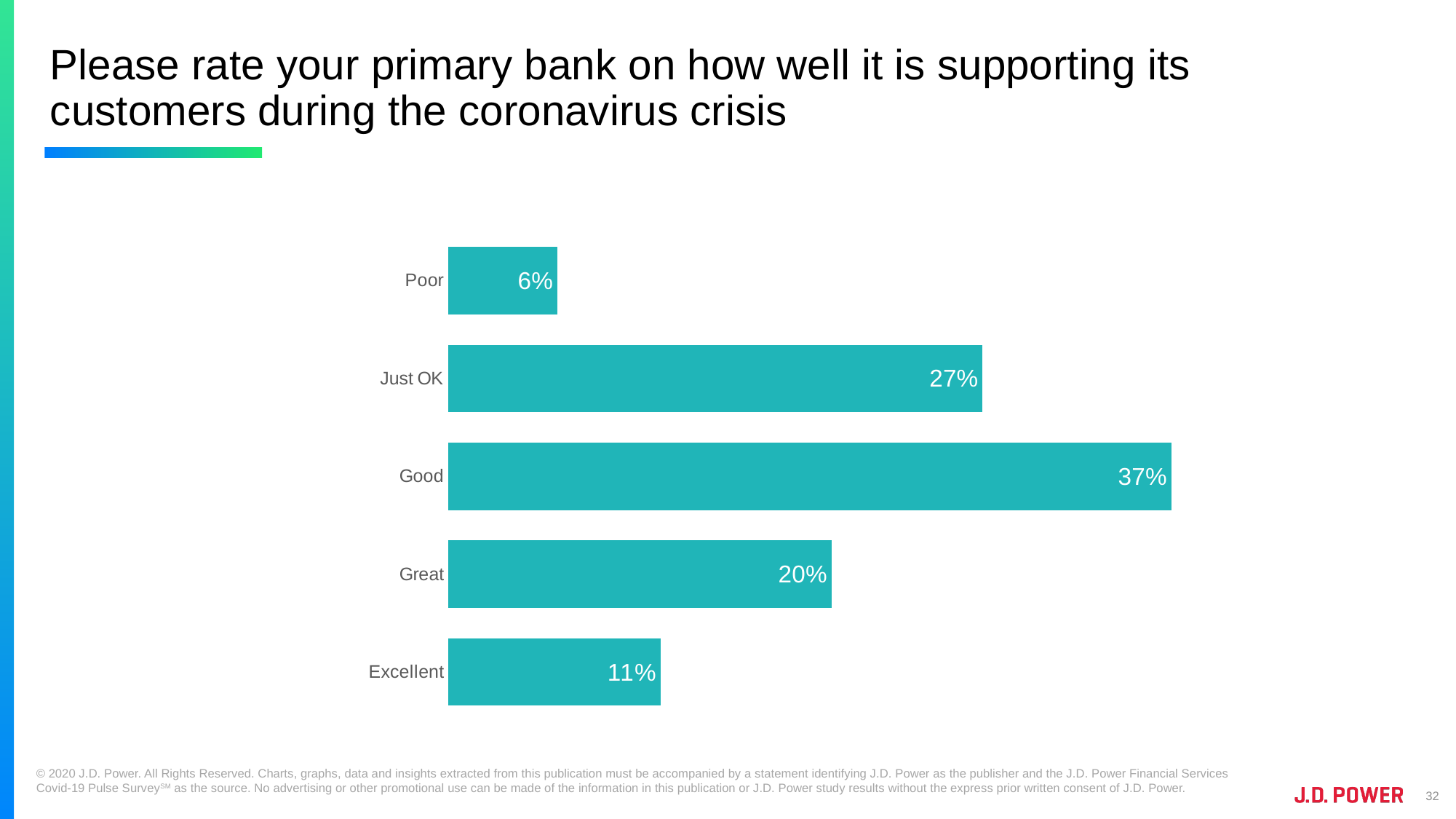
Which has a larger percentage, Just OK or Great? Just OK How many rating categories are shown in the chart? 5 What percentage of respondents rated their primary bank as Excellent? 11% What is the difference in percentage points between the Good and Just OK ratings? 10 What is the difference in percentage points between the Great and Excellent ratings? 9 What type of chart is shown on the slide? Bar chart What percentage of respondents rated their primary bank as Poor? 6% What percentage of respondents rated their primary bank as Good? 37% Which rating category has the highest percentage? Good Which rating category has the lowest percentage? Poor What percentage of respondents rated their primary bank as Just OK? 27% What is the combined percentage of respondents who rated their bank Great or Excellent? 31%